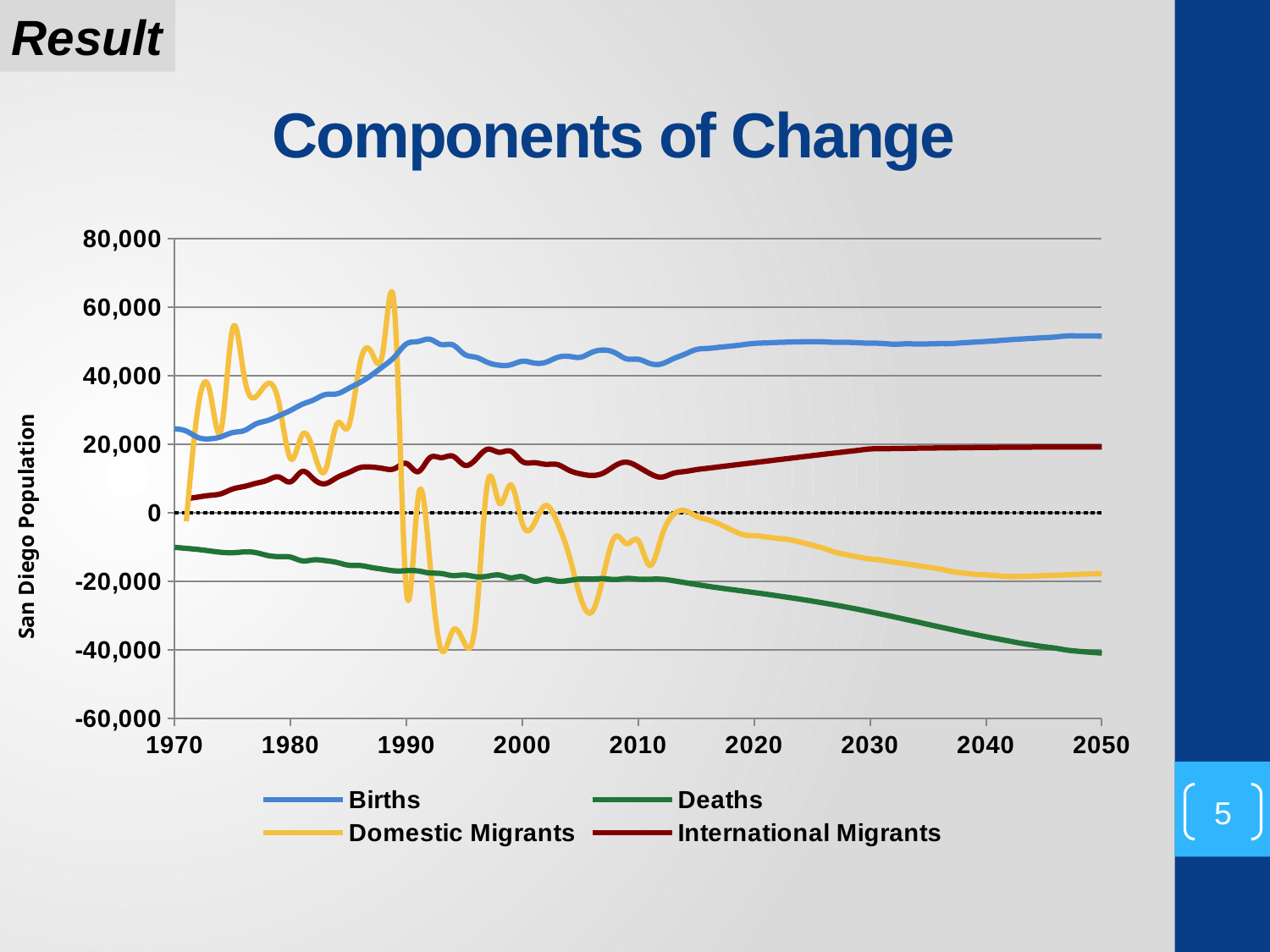
Is the value for Births in 2050 greater or less than 40,000? greater What is the label on the vertical axis? San Diego Population Is the value for Deaths in 2050 greater or less than -20,000? less Which series has the lowest value in 2050? Deaths Is the value for Domestic Migrants in 2050 greater or less than 0? less What is the title of the chart? Components of Change Do the values for Deaths rise or fall from 1970 to 2050? fall What kind of chart is shown on the slide? line chart How many series does the legend list? 4 Which series has the highest value in 2050? Births